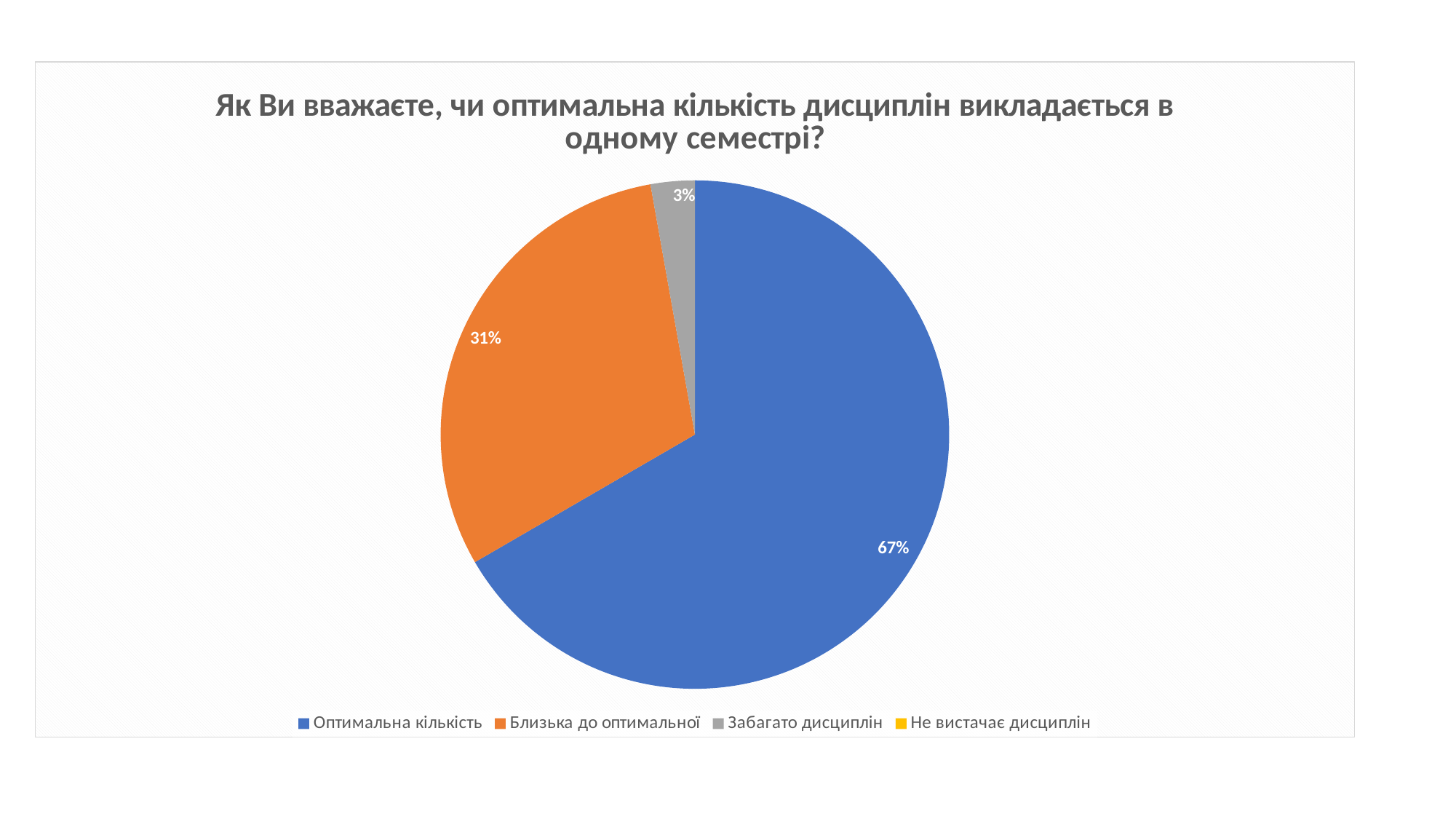
What type of chart is shown on the slide? Pie chart What share of the pie does "Забагато дисциплін" have? 3% What share of the pie does "Оптимальна кількість" have? 67% What is the title of the chart? Як Ви вважаєте, чи оптимальна кількість дисциплін викладається в одному семестрі? Which is larger: the share for "Близька до оптимальної" or the share for "Забагато дисциплін"? Близька до оптимальної Which category has the largest slice of the pie? Оптимальна кількість How many entries does the legend list? 4 What is the difference between the shares of "Оптимальна кількість" and "Близька до оптимальної"? 36 percentage points What colour is the slice for "Близька до оптимальної"? Orange How many slices with data labels are visible in the pie? 3 What share of the pie does "Близька до оптимальної" have? 31% Which labelled slice of the pie is the smallest? Забагато дисциплін